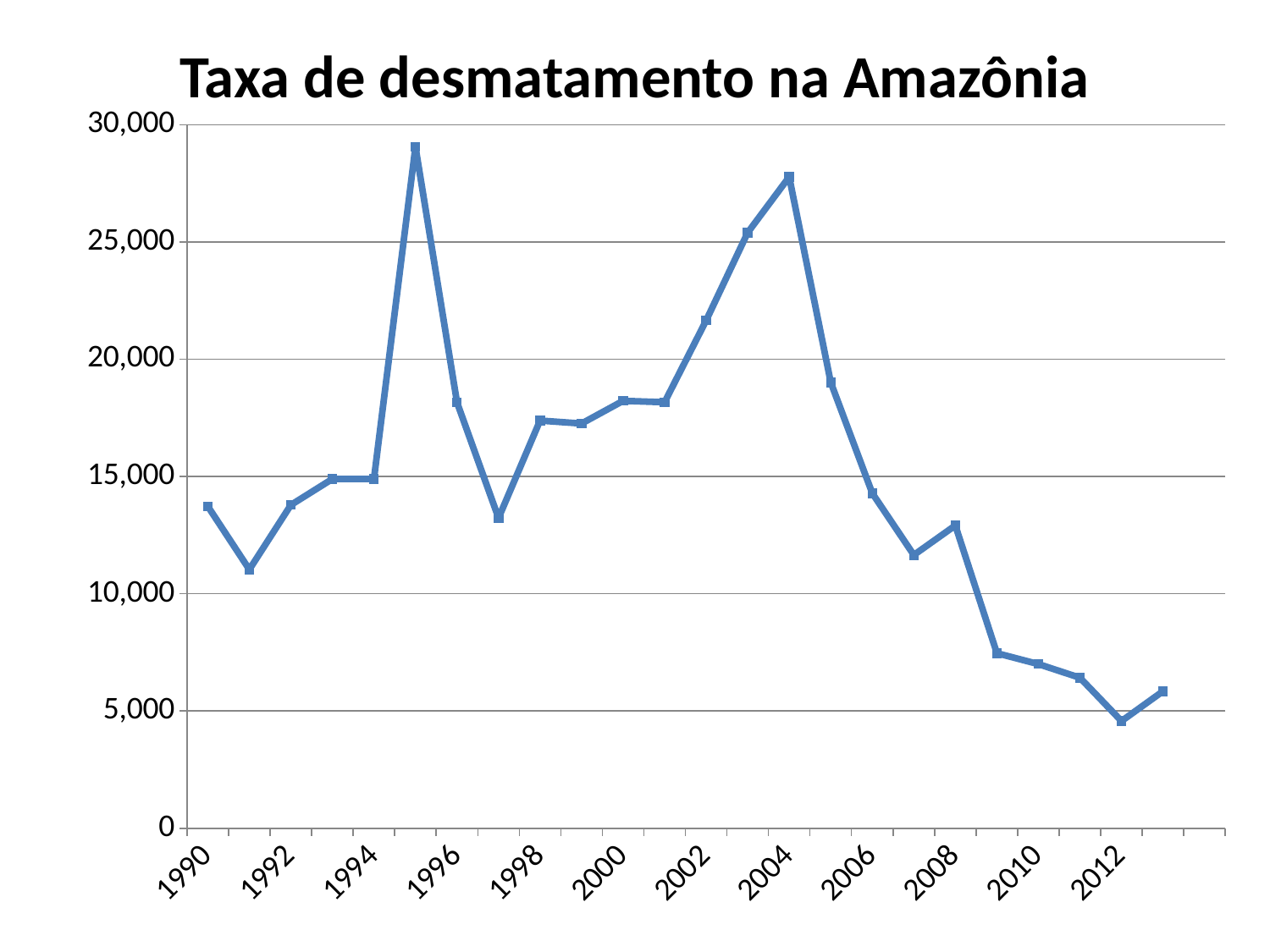
What kind of chart is shown on the slide? line chart In which year does the line reach its highest value? 1995 In which year does the line reach its lowest value? 2012 Is the value for 2010 greater or less than 10,000? less Which year has the larger value, 1995 or 2004? 1995 What is the title of the chart? Taxa de desmatamento na Amazônia Which year has the larger value, 2006 or 2008? 2006 Is the value for 1990 greater or less than 15,000? less Is the value for 1995 greater or less than 25,000? greater Do the values rise or fall from 2004 to 2012? fall